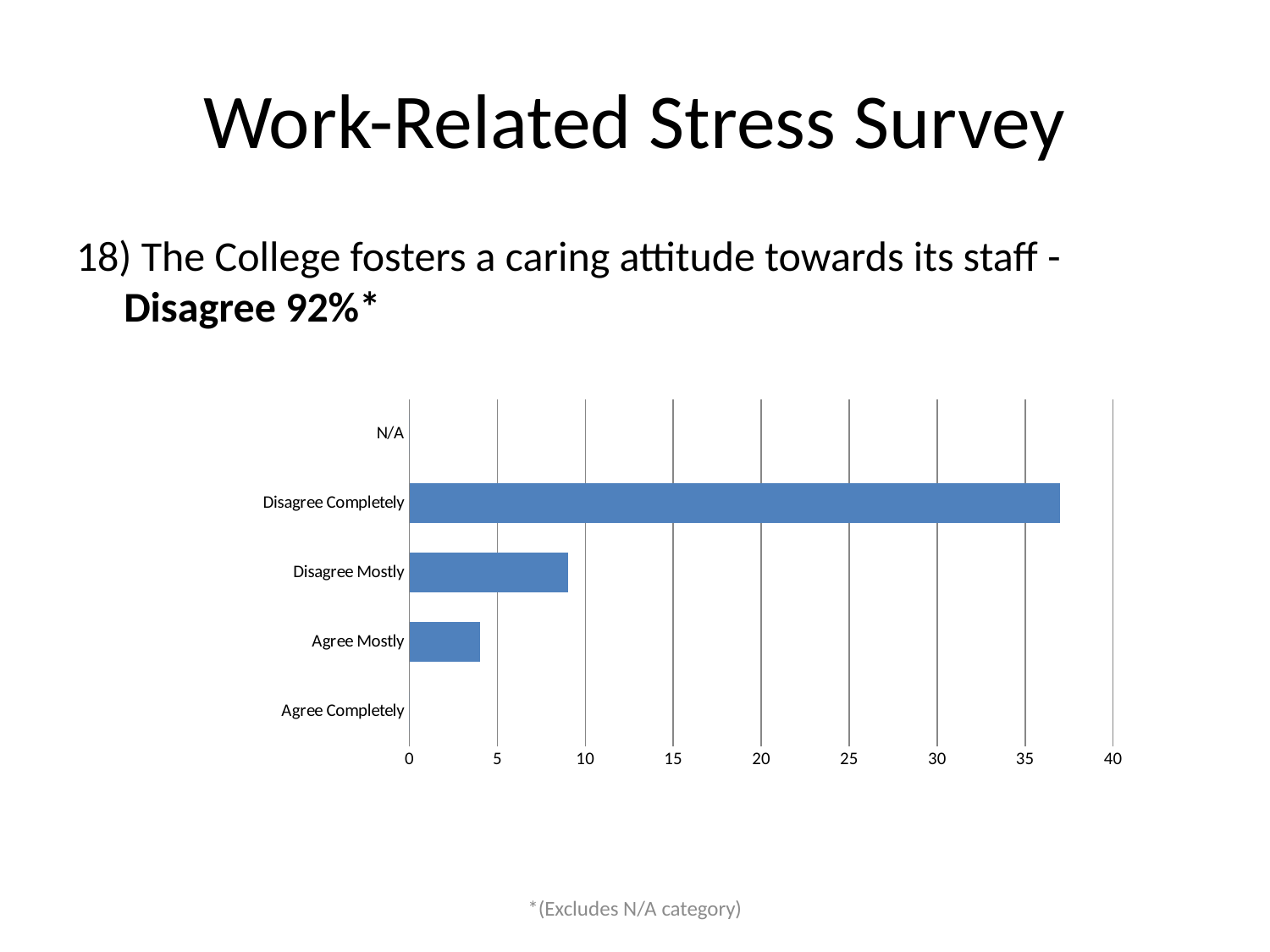
Is the value for Agree Mostly greater or less than 5? less Which category has the highest value in the chart? Disagree Completely What kind of chart is shown on the slide? bar chart Is the value for Disagree Mostly greater or less than 10? less What colour are the bars in the chart? blue Is the value for Disagree Completely greater or less than 30? greater Which is larger, the value for Disagree Mostly or the value for Agree Mostly? Disagree Mostly How many categories are shown on the chart's vertical axis? 5 Which is larger, the value for Disagree Completely or the value for Disagree Mostly? Disagree Completely What is the highest value shown on the chart's horizontal axis? 40